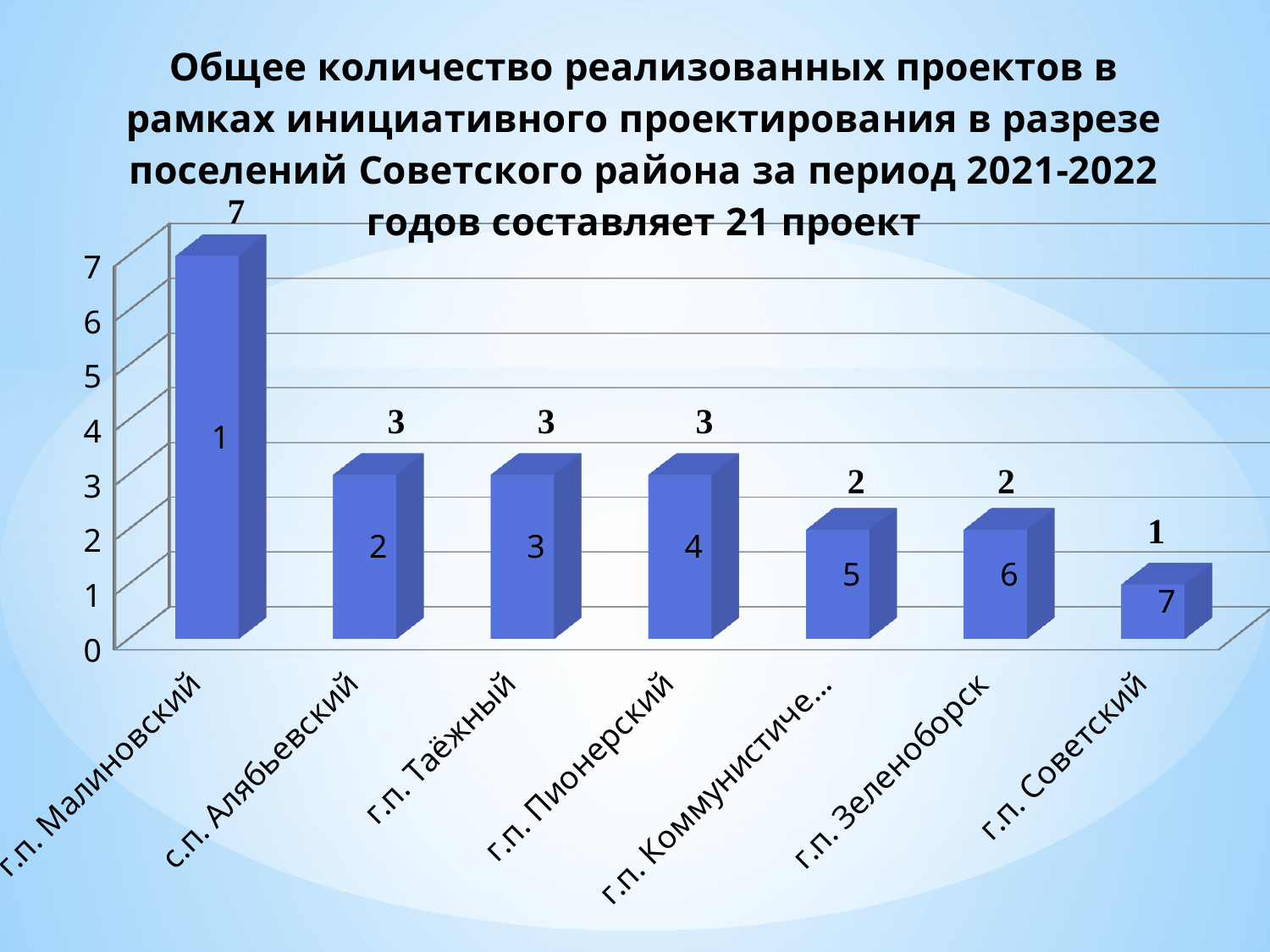
Is the value for г.п. Малиновский greater or less than 5? greater What kind of chart is shown on the slide? bar chart Which category has the lowest value? г.п. Советский Which category has the highest value? г.п. Малиновский What is the value for г.п. Малиновский? 7 What is the difference between the values for г.п. Малиновский and с.п. Алябьевский? 4 According to the chart title, how many projects were implemented in total over 2021-2022? 21 Which is larger, the value for г.п. Таёжный or the value for г.п. Зеленоборск? г.п. Таёжный What is the value for г.п. Пионерский? 3 What is the value for г.п. Советский? 1 How many categories are shown on the x axis? 7 What is the value for г.п. Зеленоборск? 2